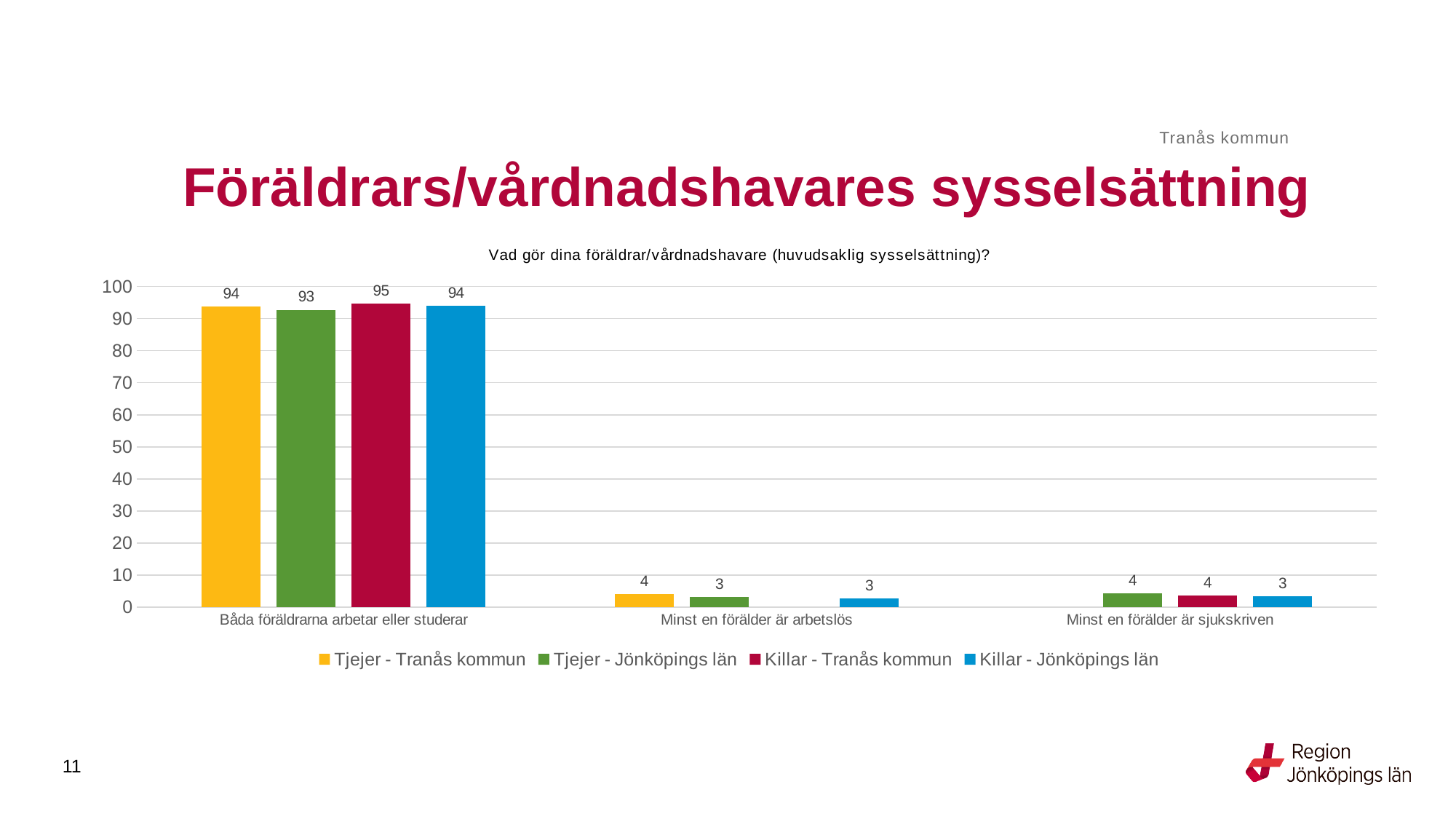
How many series does the legend list? 4 Which series has the highest value in the category 'Båda föräldrarna arbetar eller studerar'? Killar - Tranås kommun Is the value for Tjejer - Tranås kommun in 'Båda föräldrarna arbetar eller studerar' greater or less than 90? greater How many categories are shown on the x axis? 3 What is the value for Tjejer - Jönköpings län in the category 'Båda föräldrarna arbetar eller studerar'? 93 What is the subtitle (question text) shown above the chart? Vad gör dina föräldrar/vårdnadshavare (huvudsaklig sysselsättning)? What is the value for Killar - Jönköpings län in the category 'Minst en förälder är sjukskriven'? 3 What is the value for Killar - Tranås kommun in the category 'Båda föräldrarna arbetar eller studerar'? 95 What is the value for Tjejer - Tranås kommun in the category 'Minst en förälder är arbetslös'? 4 Which is larger: Tjejer - Tranås kommun in 'Minst en förälder är arbetslös' or Killar - Jönköpings län in 'Minst en förälder är arbetslös'? Tjejer - Tranås kommun What kind of chart is shown on the slide? Bar chart What is the difference between Killar - Tranås kommun and Tjejer - Jönköpings län in the category 'Båda föräldrarna arbetar eller studerar'? 2